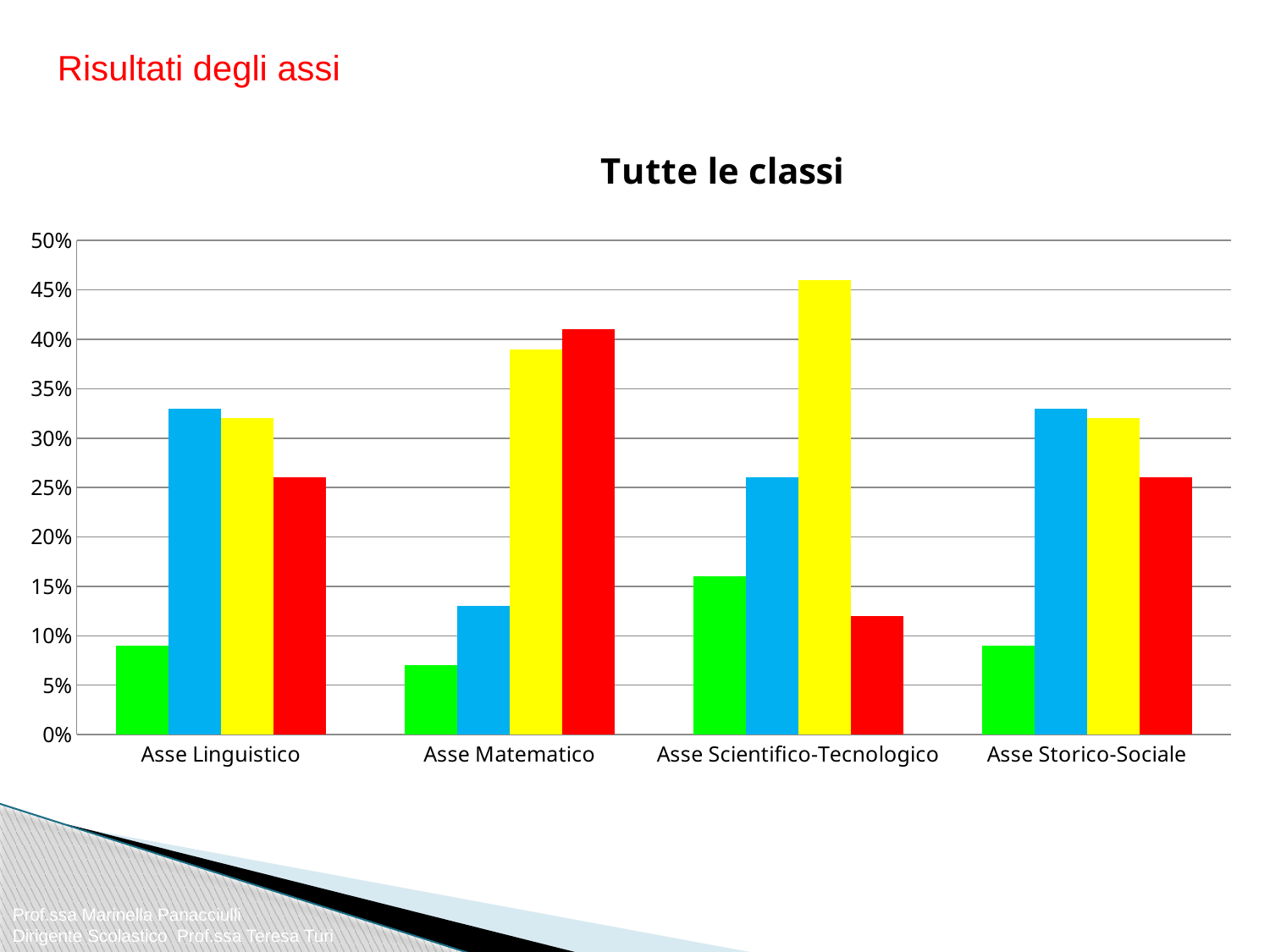
What kind of chart is shown on the slide? bar chart Is the value of the blue bar for Asse Linguistico greater or less than 30%? greater For Asse Scientifico-Tecnologico, which is larger: the yellow bar or the red bar? the yellow bar How many categories are shown on the x axis of the chart? 4 For Asse Linguistico, which is larger: the green bar or the red bar? the red bar Which category has the tallest yellow bar? Asse Scientifico-Tecnologico What is the title of the chart? Tutte le classi How many bars are plotted for each category in the chart? 4 Which category has the tallest green bar? Asse Scientifico-Tecnologico Is the value of the green bar for Asse Matematico greater or less than 10%? less Is the value of the yellow bar for Asse Scientifico-Tecnologico greater or less than 40%? greater